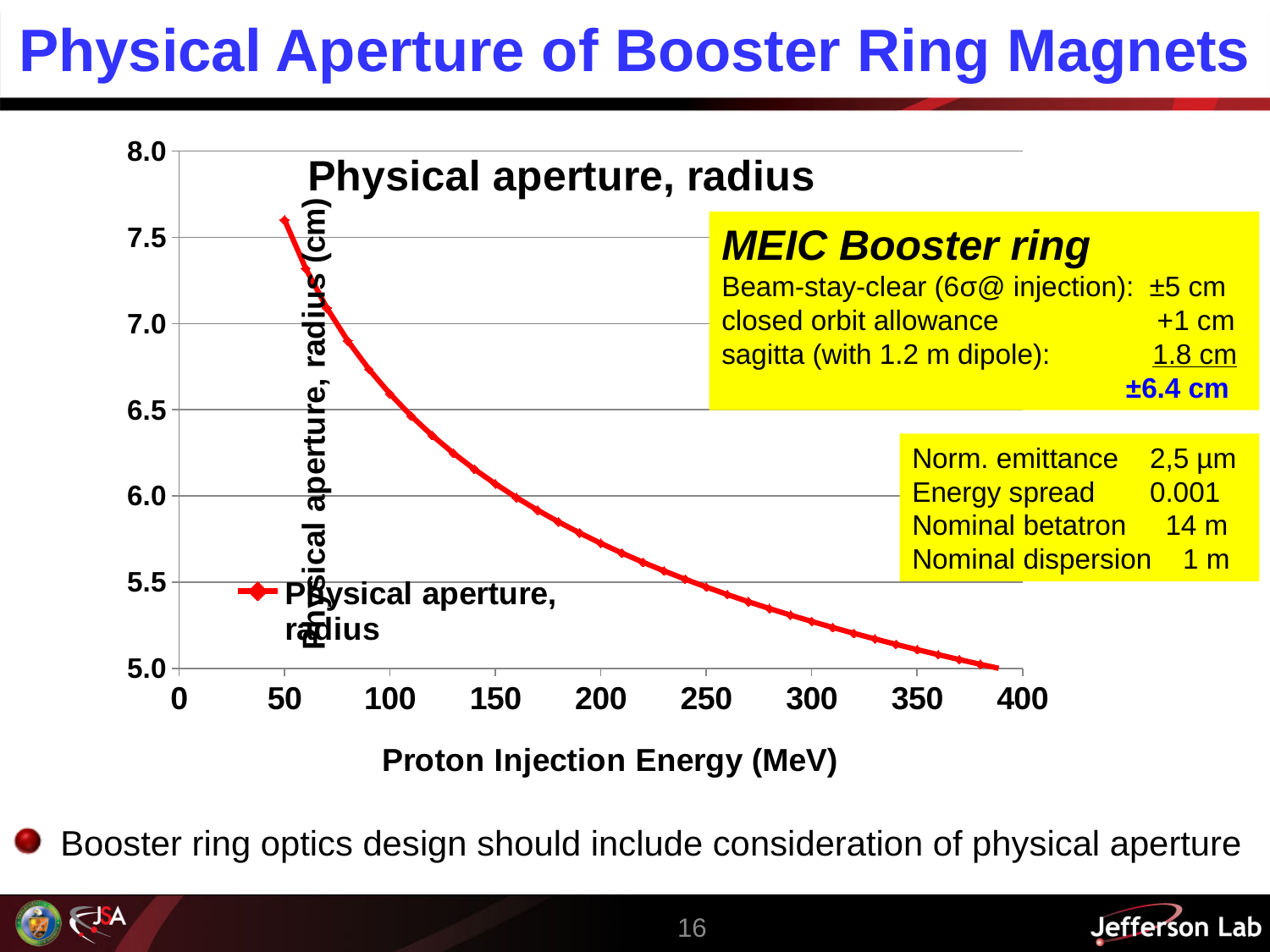
Is the physical aperture radius at 100 MeV greater or less than 6.0? greater Is the physical aperture radius at 200 MeV greater or less than 6.0? less Does the physical aperture radius rise or fall as proton injection energy increases? fall Is the physical aperture radius at 50 MeV greater or less than 7.0? greater What is the label of the x axis of the chart? Proton Injection Energy (MeV) Which has the larger physical aperture radius, 100 MeV or 300 MeV? 100 MeV What is the highest value shown on the y axis of the chart? 8.0 What is the title of the chart? Physical aperture, radius How many series does the chart legend list? 1 What kind of chart is shown on the slide? line chart